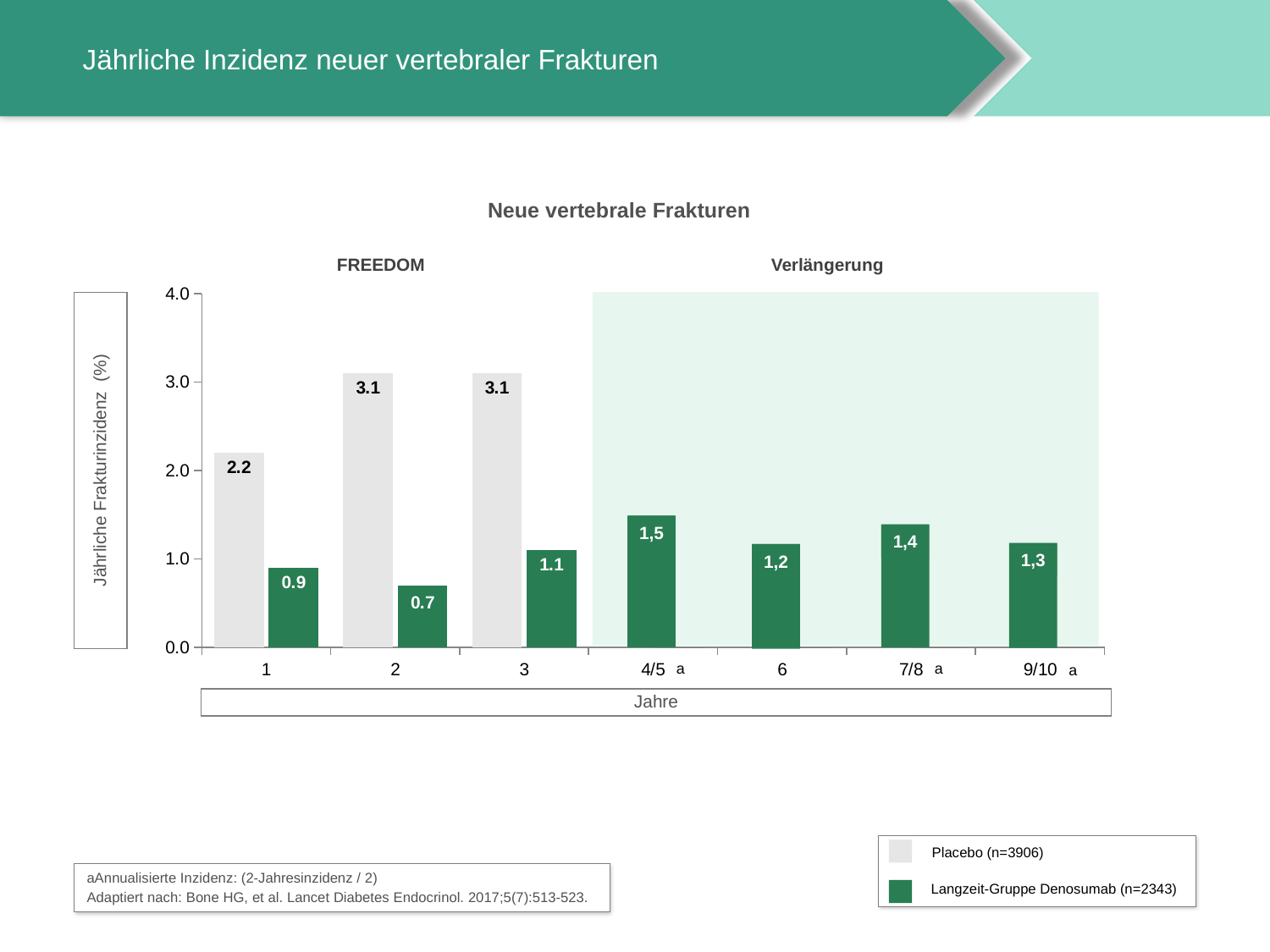
What is the value shown for the Denosumab group at years 4/5? 1,5 What kind of chart is shown on the slide? Bar chart What is the label of the y axis? Jährliche Frakturinzidenz (%) How many series does the legend list? 2 In which year is the Placebo group's annual fracture incidence lowest? 1 Which year has the lowest value for the Denosumab group? 2 What is the value shown for the Denosumab group at years 9/10? 1,3 Is the Placebo value in year 2 greater or less than 3.0? greater What is the difference between the Placebo and Denosumab values in year 3? 2.0 What is the annual fracture incidence for the Placebo group in year 1? 2.2 Which is larger in year 1: the Placebo value or the Denosumab value? Placebo What is the annual fracture incidence for the Langzeit-Gruppe Denosumab in year 2? 0.7